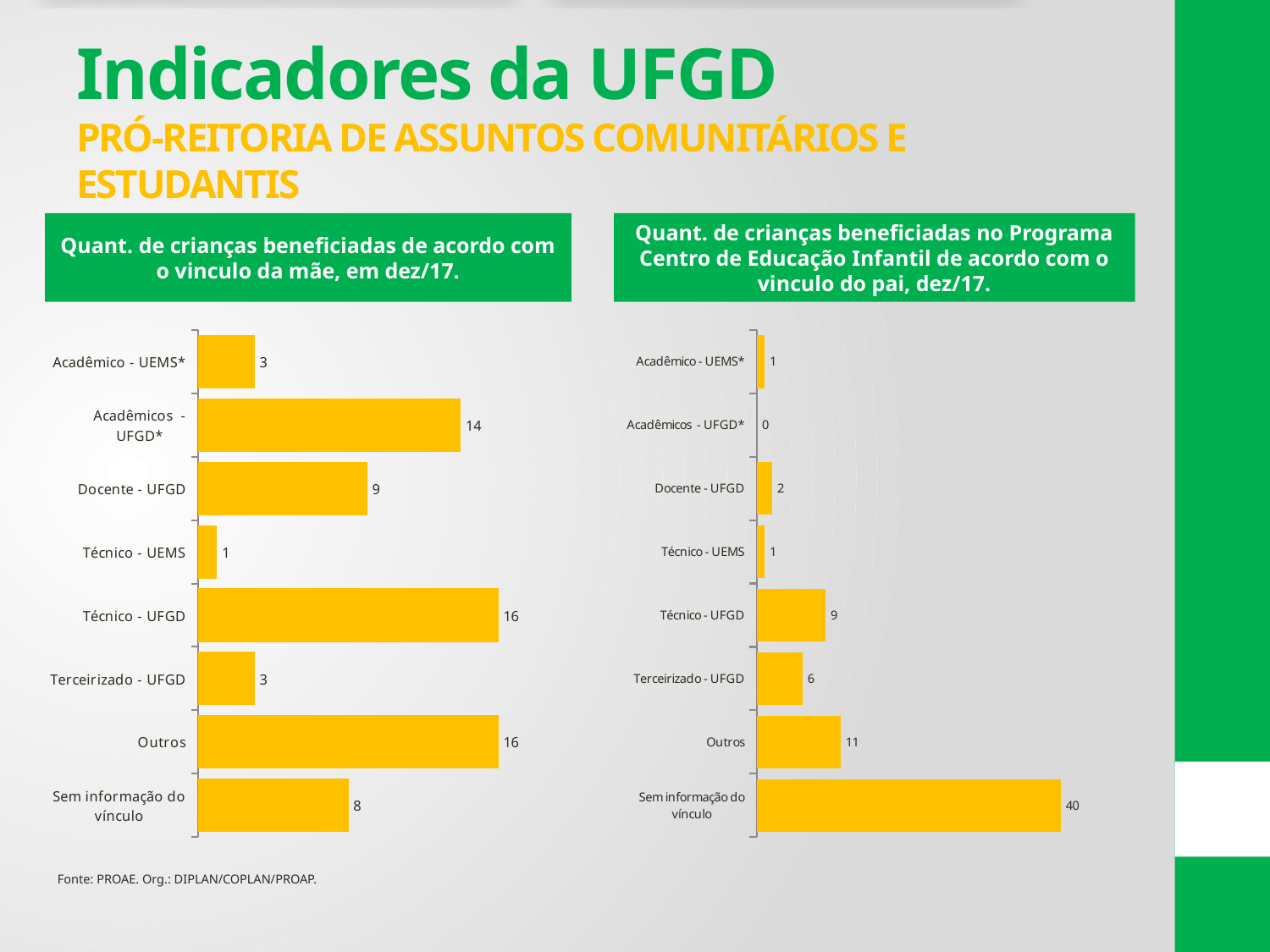
In the left chart (vínculo da mãe), which category has the lowest value? Técnico - UEMS In the right chart (vínculo do pai), what is the difference between Outros and Terceirizado - UFGD? 5 In the left chart (vínculo da mãe), what is the difference between Técnico - UFGD and Terceirizado - UFGD? 13 What type of chart is used on the left side of the slide? Bar chart In the left chart (vínculo da mãe), how many children are shown for Acadêmicos - UFGD*? 14 In the left chart (vínculo da mãe), how many categories are plotted? 8 In the left chart (vínculo da mãe), what is the value for Docente - UFGD? 9 In the right chart (vínculo do pai), which category has the lowest value? Acadêmicos - UFGD* In the right chart (vínculo do pai), which category has the highest value? Sem informação do vínculo In the right chart (vínculo do pai), which is larger: Outros or Técnico - UFGD? Outros In the right chart (vínculo do pai), what is the value for Sem informação do vínculo? 40 What is the title of the right chart? Quant. de crianças beneficiadas no Programa Centro de Educação Infantil de acordo com o vinculo do pai, dez/17.